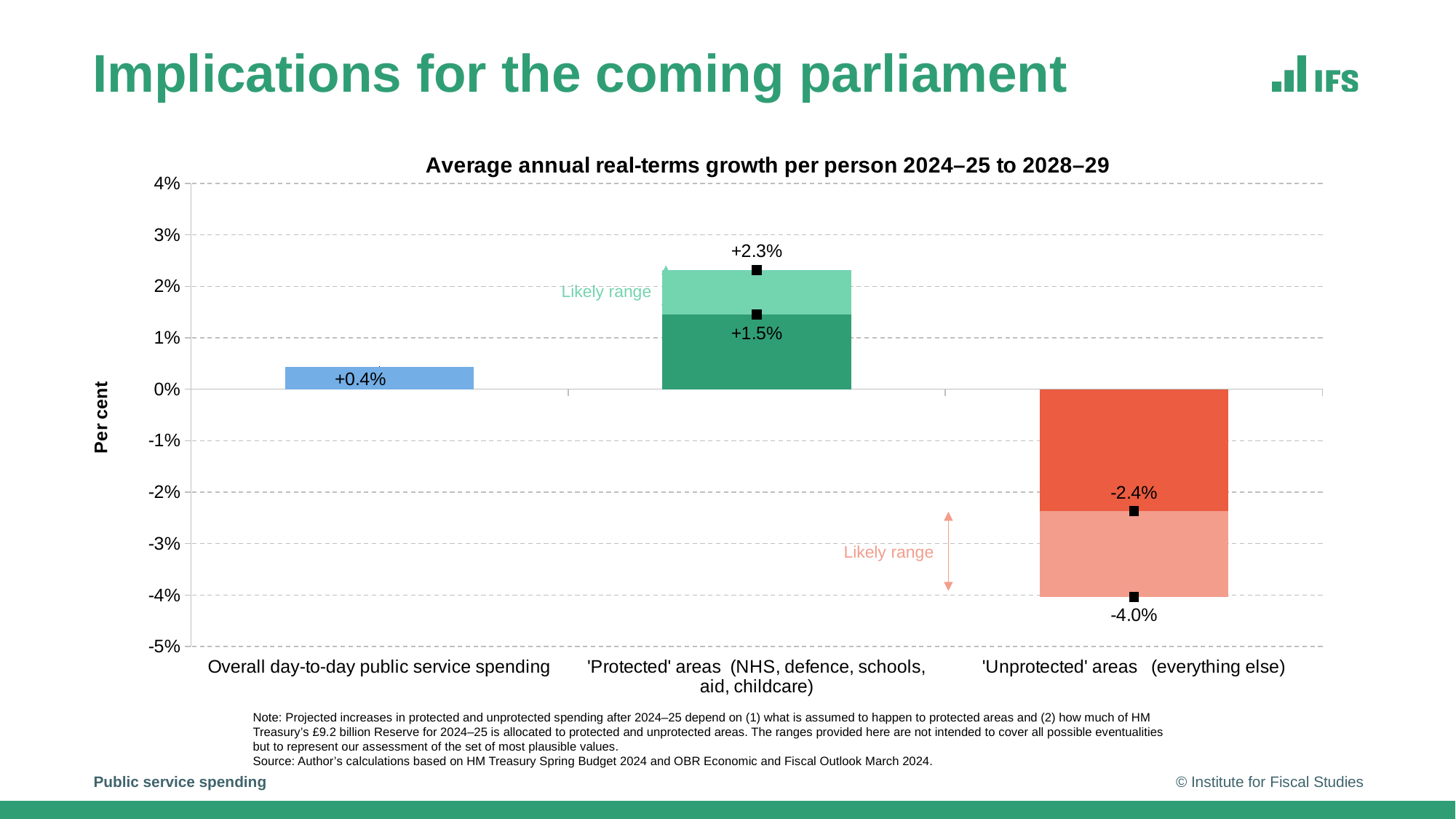
What is the difference between the upper and lower ends of the likely range for 'Protected' areas? 0.8 percentage points Which category has the lowest plotted value? 'Unprotected' areas (everything else) What is the upper end of the likely range shown for 'Protected' areas? +2.3% What is the lower end of the likely range shown for 'Protected' areas? +1.5% Which category has the highest plotted value? 'Protected' areas (NHS, defence, schools, aid, childcare) What is the difference between the upper and lower ends of the likely range for 'Unprotected' areas? 1.6 percentage points What is the lowest value shown in the likely range for 'Unprotected' areas? -4.0% What is the value shown for 'Overall day-to-day public service spending'? +0.4% What is the title of the chart? Average annual real-terms growth per person 2024–25 to 2028–29 What kind of chart is shown on the slide? Bar chart How many categories are shown on the x axis? 3 What is the upper end of the likely range shown for 'Unprotected' areas? -2.4%